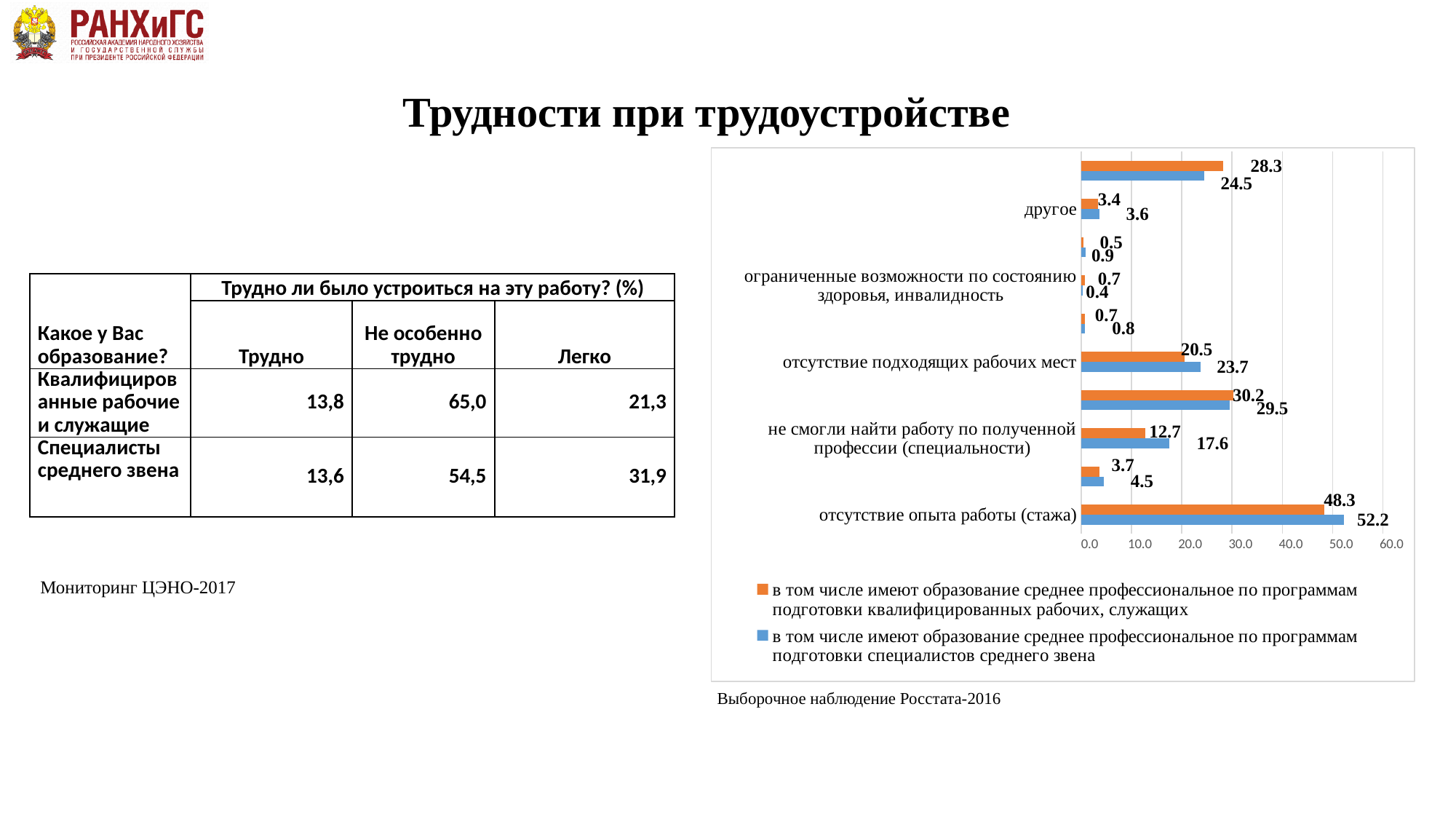
In the bar chart, what is the value for 'отсутствие опыта работы (стажа)' for the series 'в том числе имеют образование среднее профессиональное по программам подготовки квалифицированных рабочих, служащих'? 48.3 In the bar chart, what is the difference between the two series' values for 'отсутствие опыта работы (стажа)'? 3.9 In the bar chart, what is the value for 'другое' for the series 'подготовки специалистов среднего звена'? 3.6 What kind of chart is shown on the right side of the slide? bar chart How many series does the legend of the bar chart list? 2 In the bar chart, what colour represents the series 'подготовки специалистов среднего звена'? blue In the bar chart, what is the value for 'отсутствие опыта работы (стажа)' for the series 'в том числе имеют образование среднее профессиональное по программам подготовки специалистов среднего звена'? 52.2 In the bar chart, which labelled category has the highest value for the series 'подготовки специалистов среднего звена'? отсутствие опыта работы (стажа) In the bar chart, what is the difference between the two series' values for 'отсутствие подходящих рабочих мест'? 3.2 In the bar chart, what is the value for 'отсутствие подходящих рабочих мест' for the series 'подготовки квалифицированных рабочих, служащих'? 20.5 In the bar chart, for 'не смогли найти работу по полученной профессии (специальности)', which series has the larger value? в том числе имеют образование среднее профессиональное по программам подготовки специалистов среднего звена How many pairs of bars (categories) are plotted in the bar chart? 10